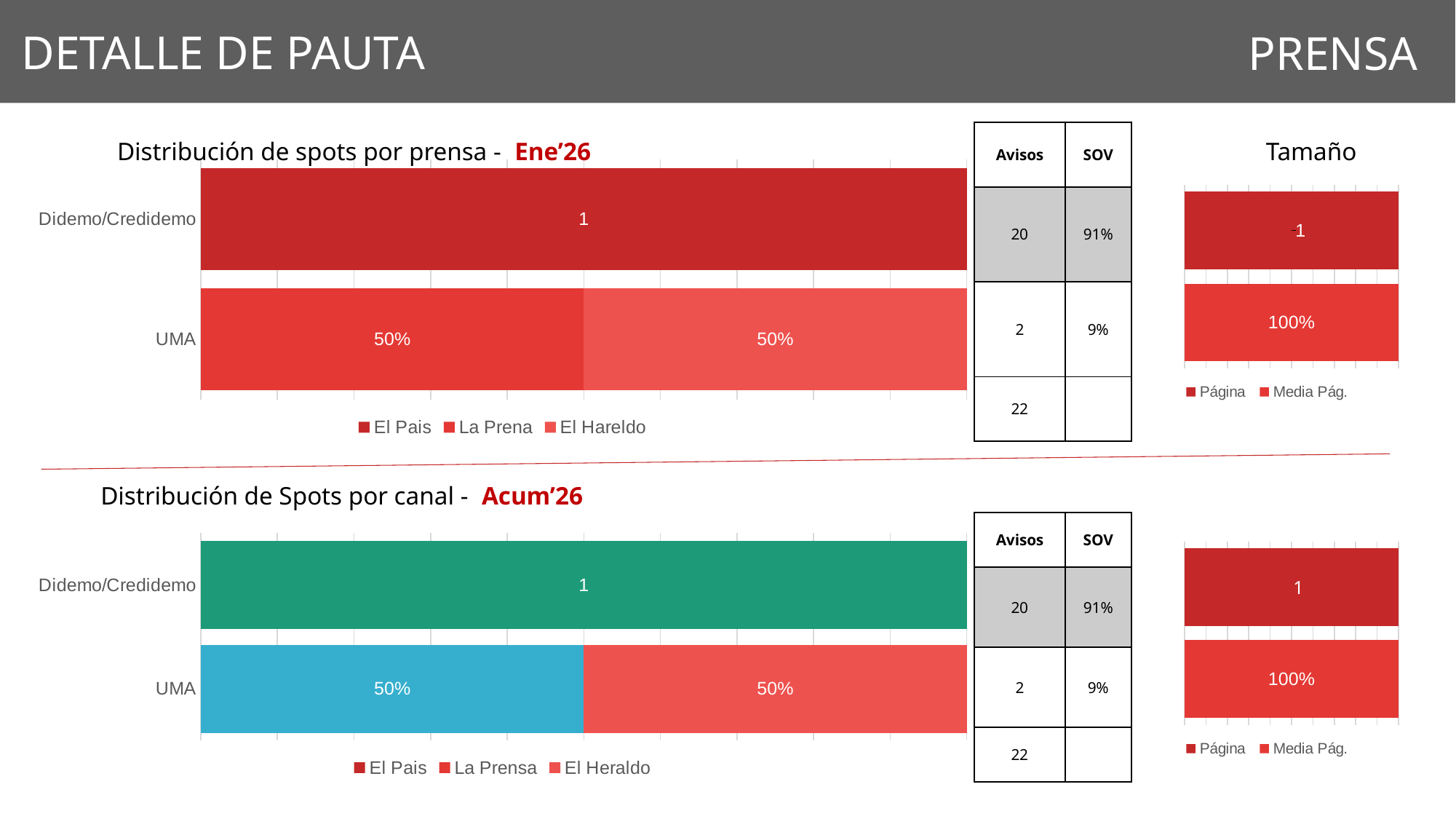
In the chart titled 'Distribución de Spots por canal - Acum'26', what kind of chart is shown? bar chart In the chart titled 'Distribución de spots por prensa - Ene'26', what are the legend entries? El Pais, La Prena, El Hareldo In the chart titled 'Distribución de spots por prensa - Ene'26', how many categories are shown on the vertical axis? 2 In the chart titled 'Distribución de spots por prensa - Ene'26', what value is labelled on the Didemo/Credidemo bar? 1 In the chart titled 'Distribución de spots por prensa - Ene'26', what is the value of the La Prena segment for UMA? 50% In the chart titled 'Distribución de Spots por canal - Acum'26', how many series does the legend list? 3 In the chart titled 'Distribución de Spots por canal - Acum'26', what is the value of the El Heraldo segment for UMA? 50% In the chart titled 'Distribución de spots por prensa - Ene'26', how many series does the legend list? 3 In the chart titled 'Tamaño' at the top right, what value is labelled on the UMA bar? 100% In the chart titled 'Distribución de Spots por canal - Acum'26', how many categories are shown on the vertical axis? 2 In the chart titled 'Tamaño' at the top right, what are the legend entries? Página, Media Pág. In the chart titled 'Distribución de spots por prensa - Ene'26', what kind of chart is shown? bar chart